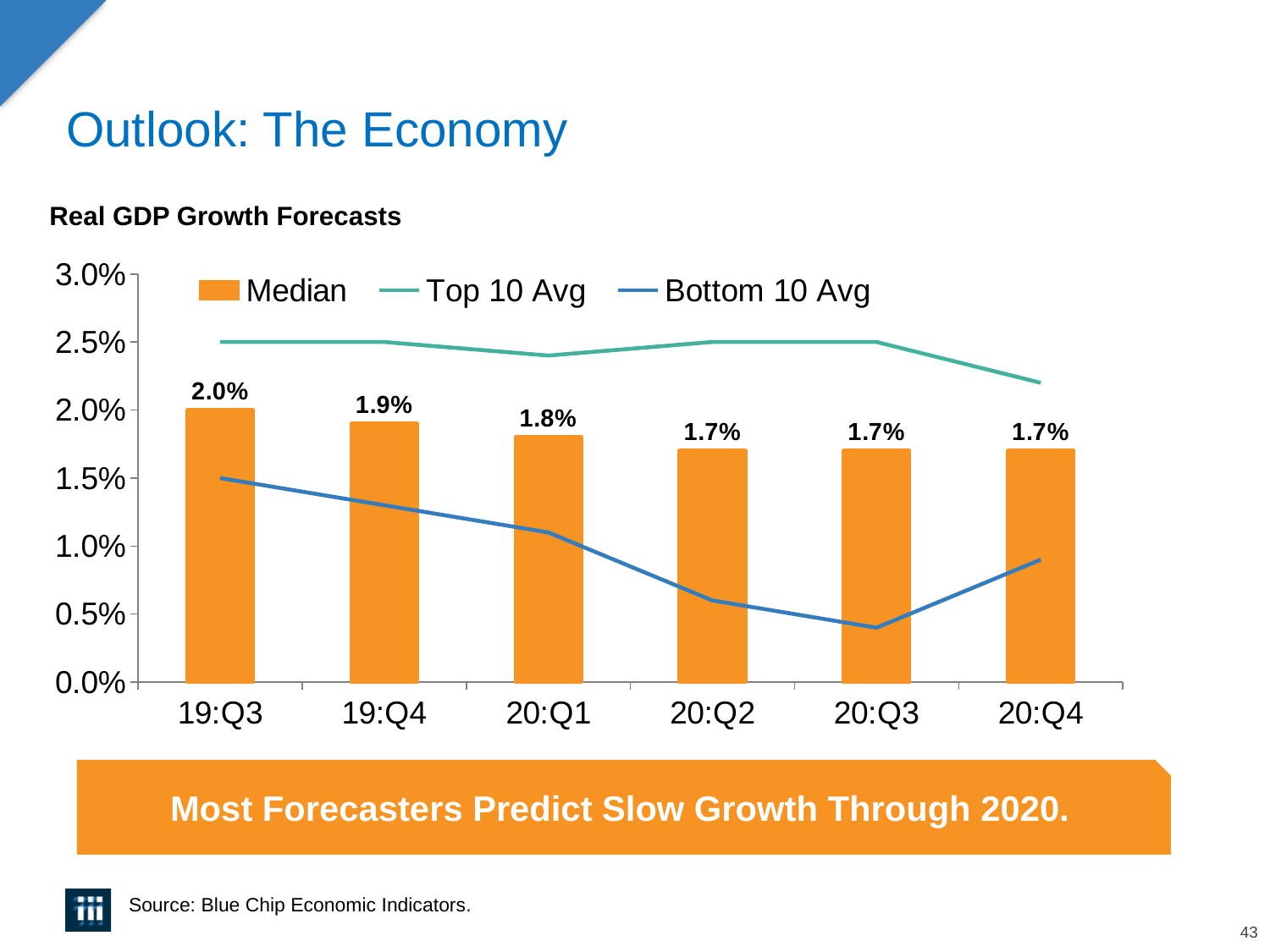
What colour are the Median bars? Orange What is the Median real GDP growth forecast for 19:Q3? 2.0% How many quarters are shown on the x axis? 6 What is the Median real GDP growth forecast for 20:Q1? 1.8% How many series does the legend list? 3 What is the difference between the Median forecast for 19:Q3 and for 20:Q4? 0.3% Do the Median forecasts rise or fall from 19:Q3 to 20:Q4? Fall Which quarter has the highest Median forecast? 19:Q3 Is the Top 10 Avg value for 20:Q2 greater or less than 2.0%? greater Which is larger, the Median forecast for 19:Q4 or for 20:Q2? 19:Q4 What kind of chart is shown on the slide? Combined bar and line chart Is the Bottom 10 Avg value for 20:Q3 greater or less than 1.0%? less